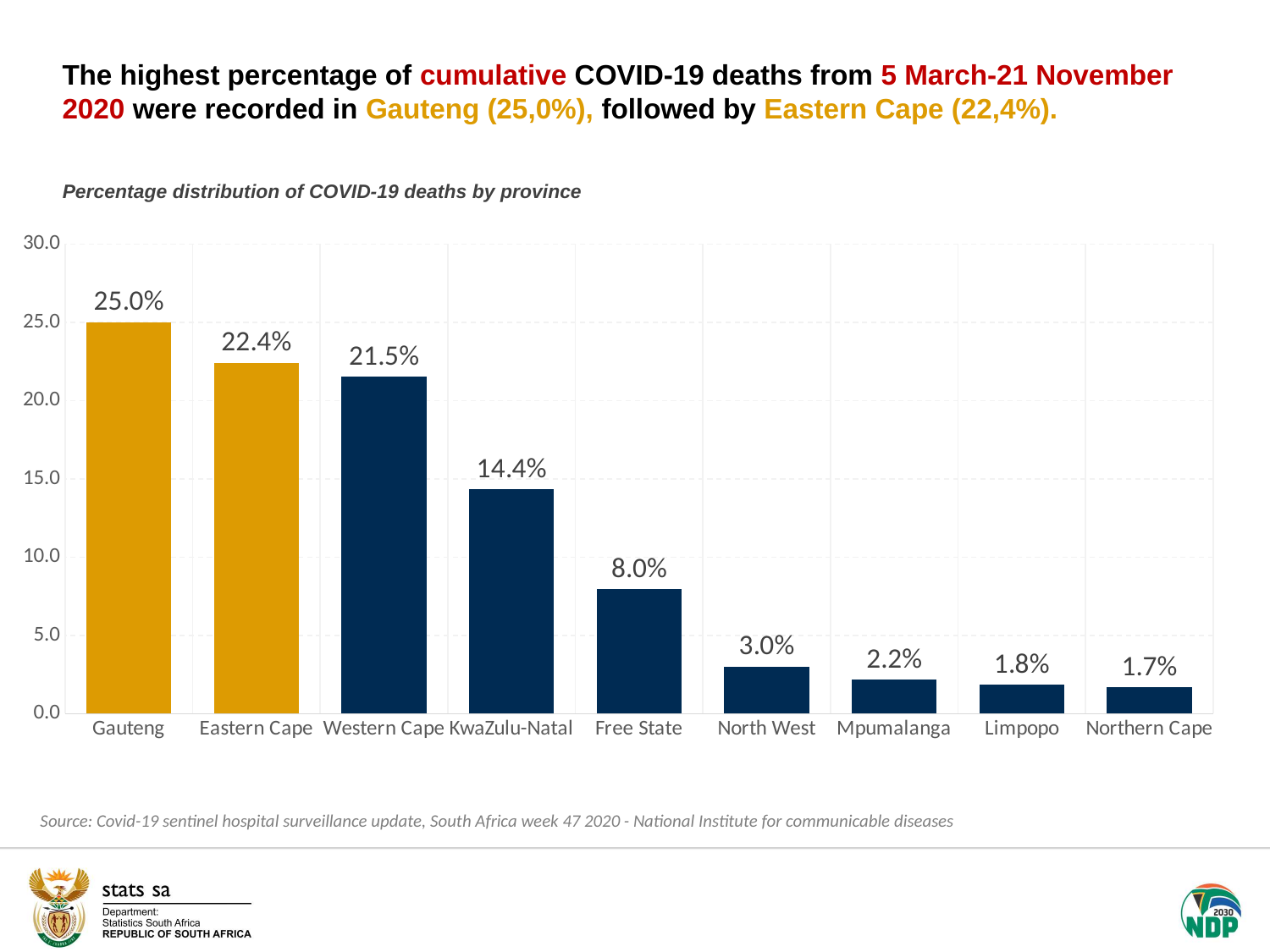
What percentage is shown for Free State? 8.0% What percentage of COVID-19 deaths is shown for Western Cape? 21.5% What kind of chart is shown on the slide? Bar chart Which province has the highest percentage of COVID-19 deaths? Gauteng What is the value for KwaZulu-Natal? 14.4% What is the difference between the values for Gauteng and Eastern Cape? 2.6% Is the value for Free State greater or less than 10.0? less Which two provinces have bars coloured gold rather than dark blue? Gauteng and Eastern Cape How many provinces are shown on the chart? 9 Which is larger, the value for North West or the value for Mpumalanga? North West Which province has the lowest percentage of COVID-19 deaths? Northern Cape What is the difference between the values for Western Cape and KwaZulu-Natal? 7.1%